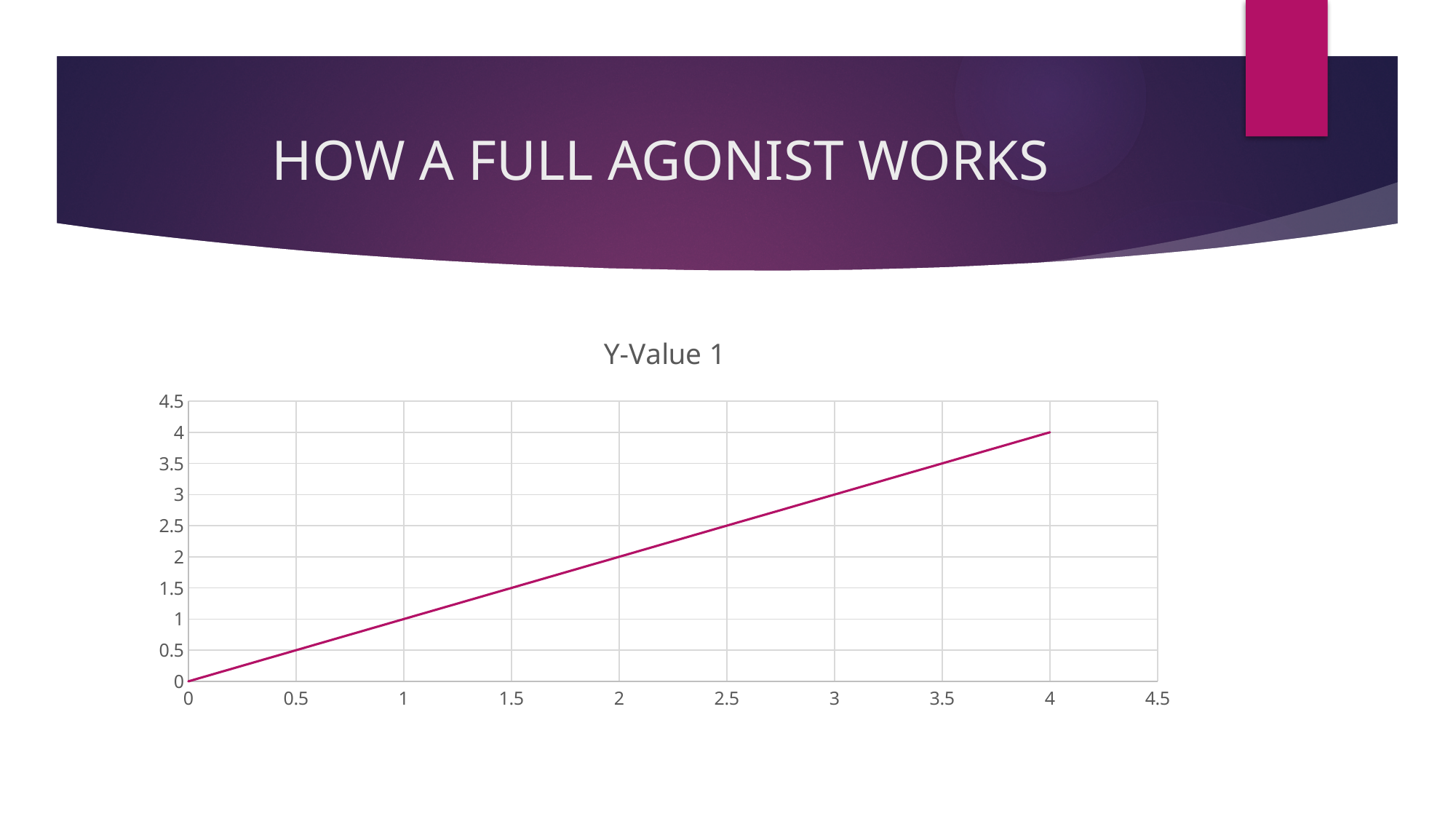
What is the title of the chart? Y-Value 1 Does the line rise or fall as the x value increases? rises Is the y value of the line at x = 3 greater or less than 2.5? greater What is the y value of the line at x = 4? 4 What is the y value of the line at x = 0? 0 Is the y value of the line at x = 1 greater or less than 1.5? less Which has the larger y value on the line: x = 3 or x = 1? x = 3 What is the y value of the line at x = 2? 2 What is the highest y value reached by the line? 4 What is the difference between the y value at x = 4 and the y value at x = 0? 4 What kind of chart is shown on the slide? line chart What is the highest tick label shown on the y axis? 4.5